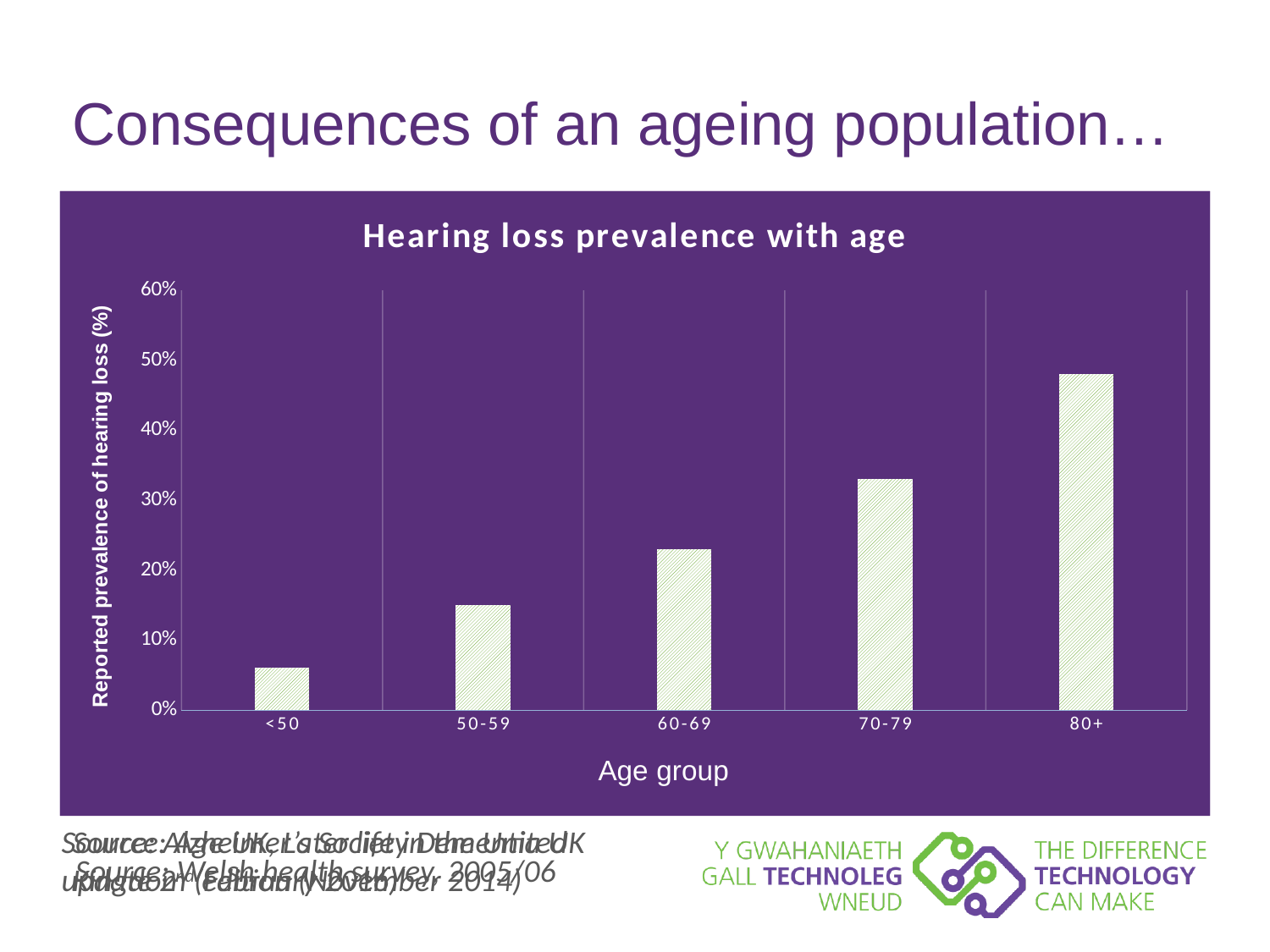
How many age groups are plotted on the chart? 5 Is the value for the 80+ age group greater or less than 50%? less Is the value for the <50 age group greater or less than 10%? less Is the value for the 50-59 age group greater or less than 10%? greater Which age group has the highest reported prevalence of hearing loss? 80+ Which age group has the lowest reported prevalence of hearing loss? <50 What is the title of the chart? Hearing loss prevalence with age Do the values rise or fall as age group increases along the x axis? rise What kind of chart is shown on the slide? bar chart Which has a higher reported prevalence of hearing loss, the 60-69 age group or the 70-79 age group? 70-79